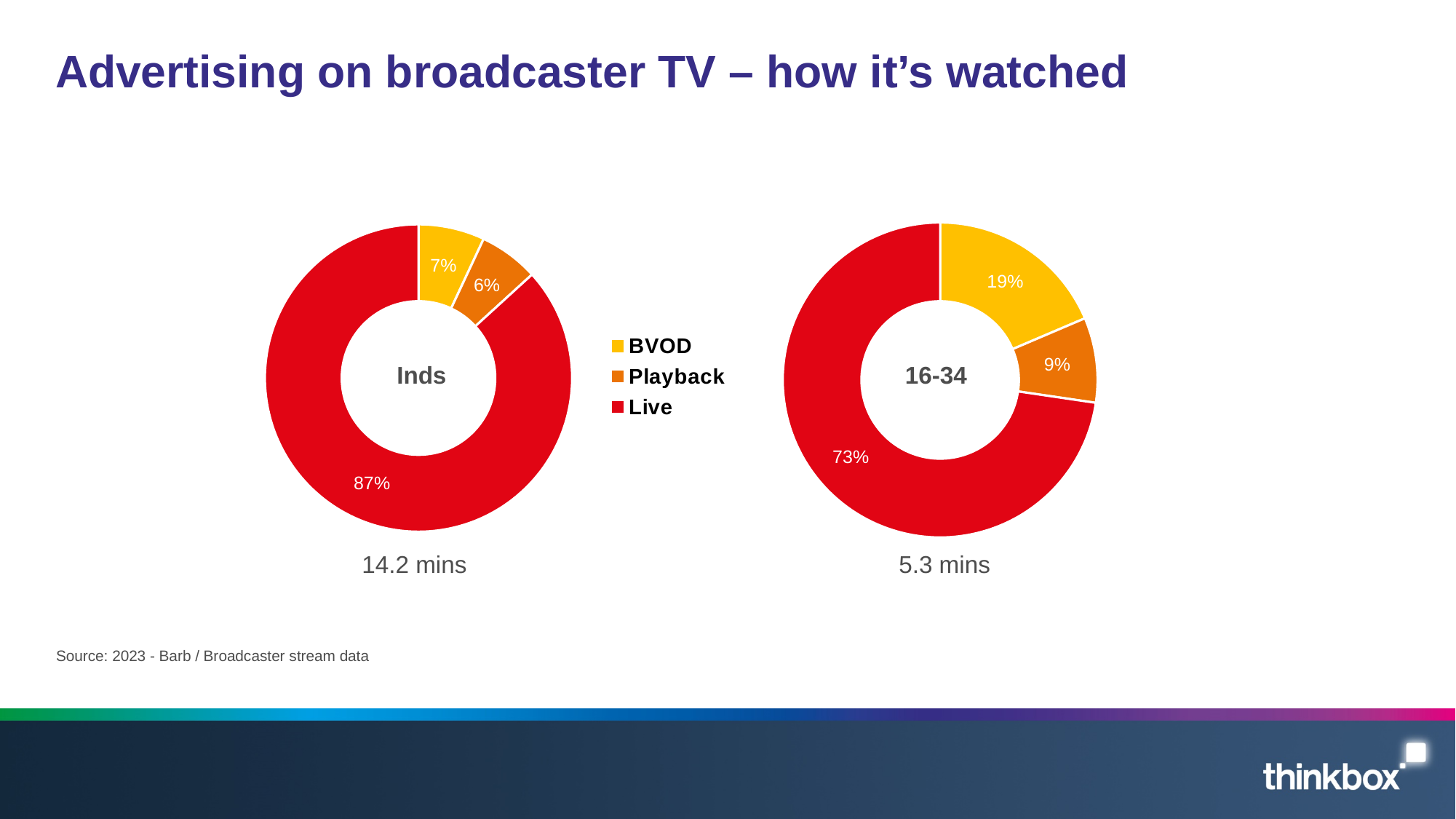
How many categories does the legend list? 3 In the 16-34 chart, which category has the largest share? Live What is the difference between the Live share in the Inds chart and the Live share in the 16-34 chart? 14 percentage points In the 16-34 chart, what share is Playback? 9% In the Inds chart, which category has the smallest share? Playback What is the minutes figure shown below the Inds chart? 14.2 mins In the Inds chart, what share is Playback? 6% Which is larger: the BVOD share in the Inds chart or the BVOD share in the 16-34 chart? 16-34 What colour represents Live in the legend? Red In the 16-34 chart, what share of advertising viewing is BVOD? 19% What type of chart is used on this slide? Pie (doughnut) chart In the Inds chart, what share of advertising viewing is Live? 87%